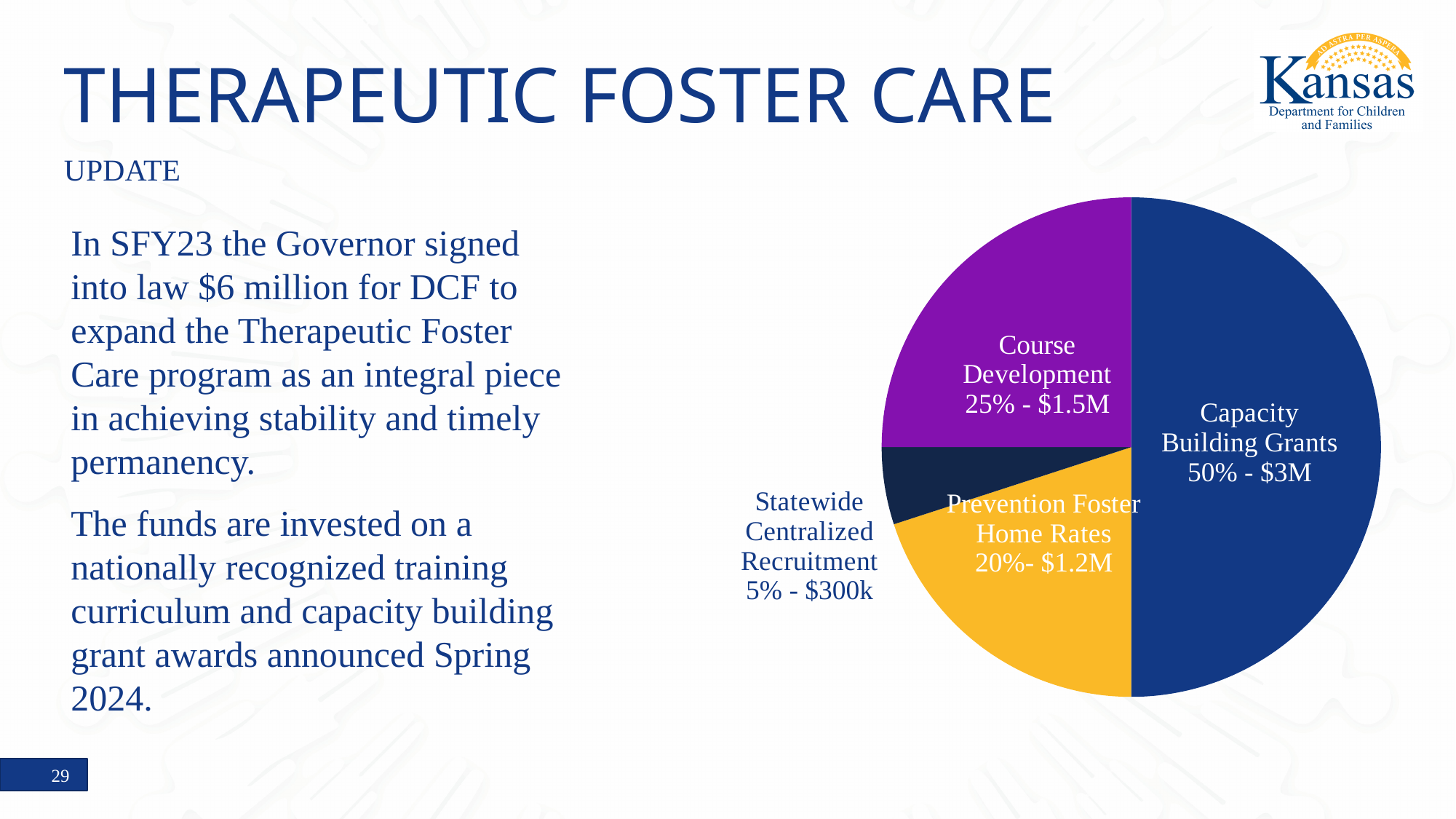
What colour is the Course Development slice? purple What share of the pie does Capacity Building Grants represent? 50% What is the difference in percentage points between Capacity Building Grants and Course Development? 25 What dollar amount is shown for Statewide Centralized Recruitment? $300k Which slice of the pie chart is the largest? Capacity Building Grants What dollar amount is shown for Course Development? $1.5M Which slice of the pie chart is the smallest? Statewide Centralized Recruitment What share of the pie does Prevention Foster Home Rates represent? 20% Which is larger, the share for Course Development or the share for Prevention Foster Home Rates? Course Development What kind of chart is shown on the slide? pie chart How many slices does the pie chart have? 4 What dollar amount is shown for Prevention Foster Home Rates? $1.2M